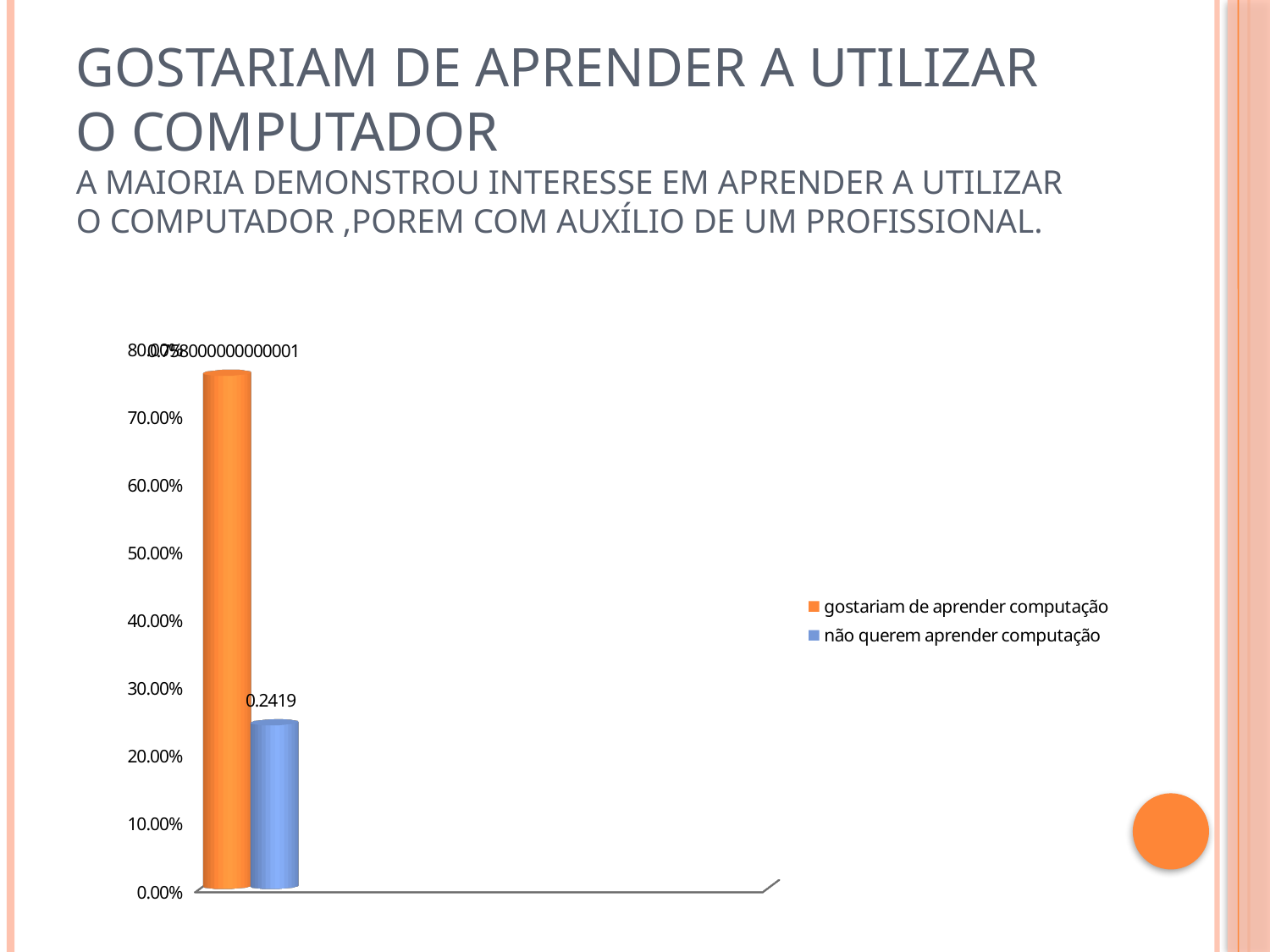
Which is larger: the bar for "gostariam de aprender computação" or the bar for "não querem aprender computação"? gostariam de aprender computação Which series has the highest bar? gostariam de aprender computação What value is labelled on the bar for "não querem aprender computação"? 0.2419 What kind of chart is shown on the slide? bar chart Which series has the lowest bar? não querem aprender computação Is the value for "gostariam de aprender computação" greater or less than 50.00%? greater What colour is the bar for "não querem aprender computação"? blue What colour is the bar for "gostariam de aprender computação"? orange How many bars are plotted in the chart? 2 Is the value for "não querem aprender computação" greater or less than 30.00%? less How many series does the legend list? 2 Is the value for "gostariam de aprender computação" greater or less than 70.00%? greater